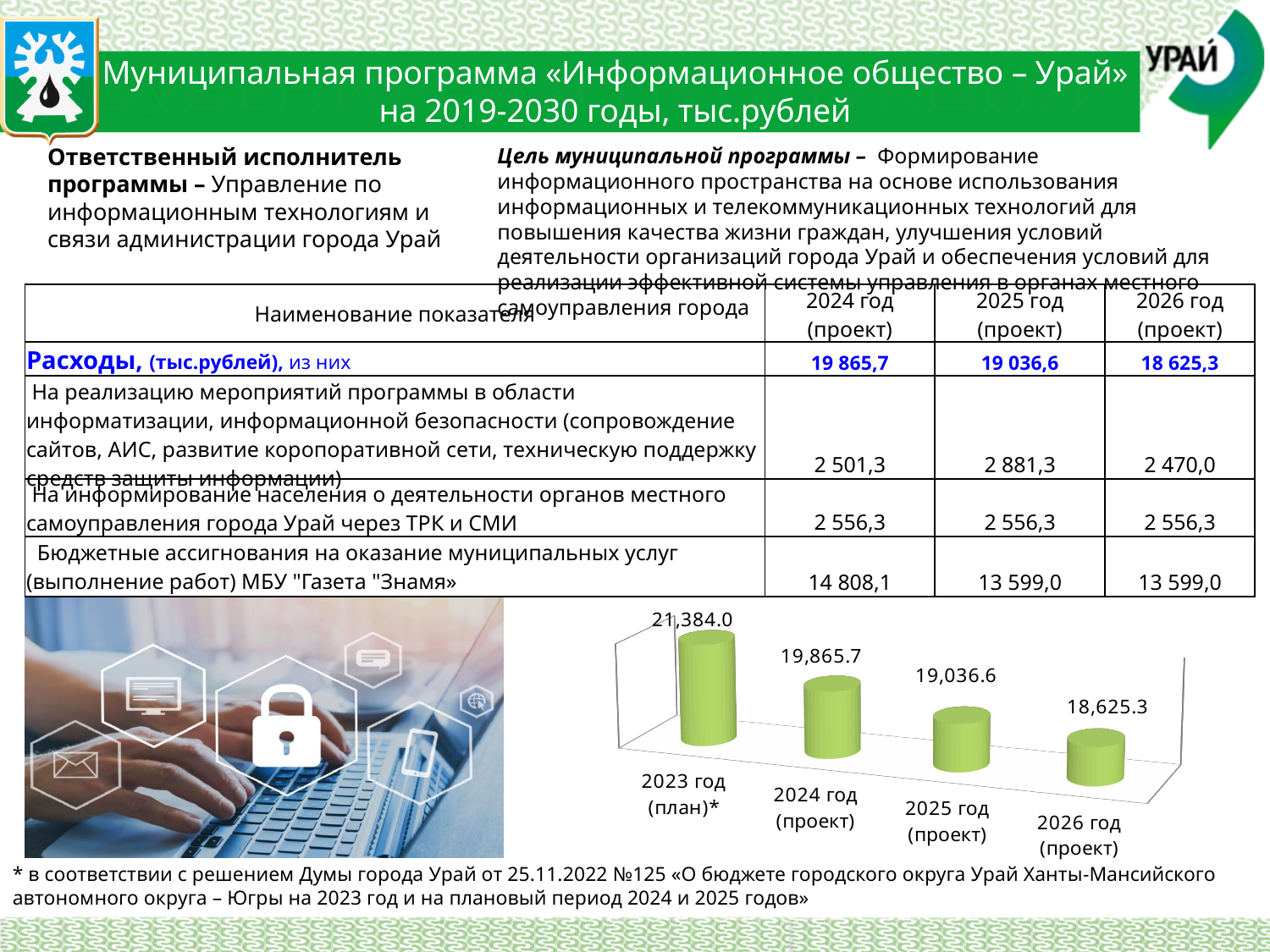
How many years are shown in the chart? 4 What value does the chart show for 2025 год (проект)? 19,036.6 What kind of chart is shown on the slide? Bar chart What value does the chart show for 2023 год (план)*? 21,384.0 Do the values in the chart rise or fall from 2023 to 2026? Fall What is the difference between the values for 2023 год (план)* and 2026 год (проект)? 2,758.7 Which year has the highest value in the chart? 2023 год (план)* What value does the chart show for 2026 год (проект)? 18,625.3 What is the difference between the values for 2023 год (план)* and 2024 год (проект)? 1,518.3 What value does the chart show for 2024 год (проект)? 19,865.7 Which year has the lowest value in the chart? 2026 год (проект) Which is larger, the value for 2024 год (проект) or the value for 2025 год (проект)? 2024 год (проект)